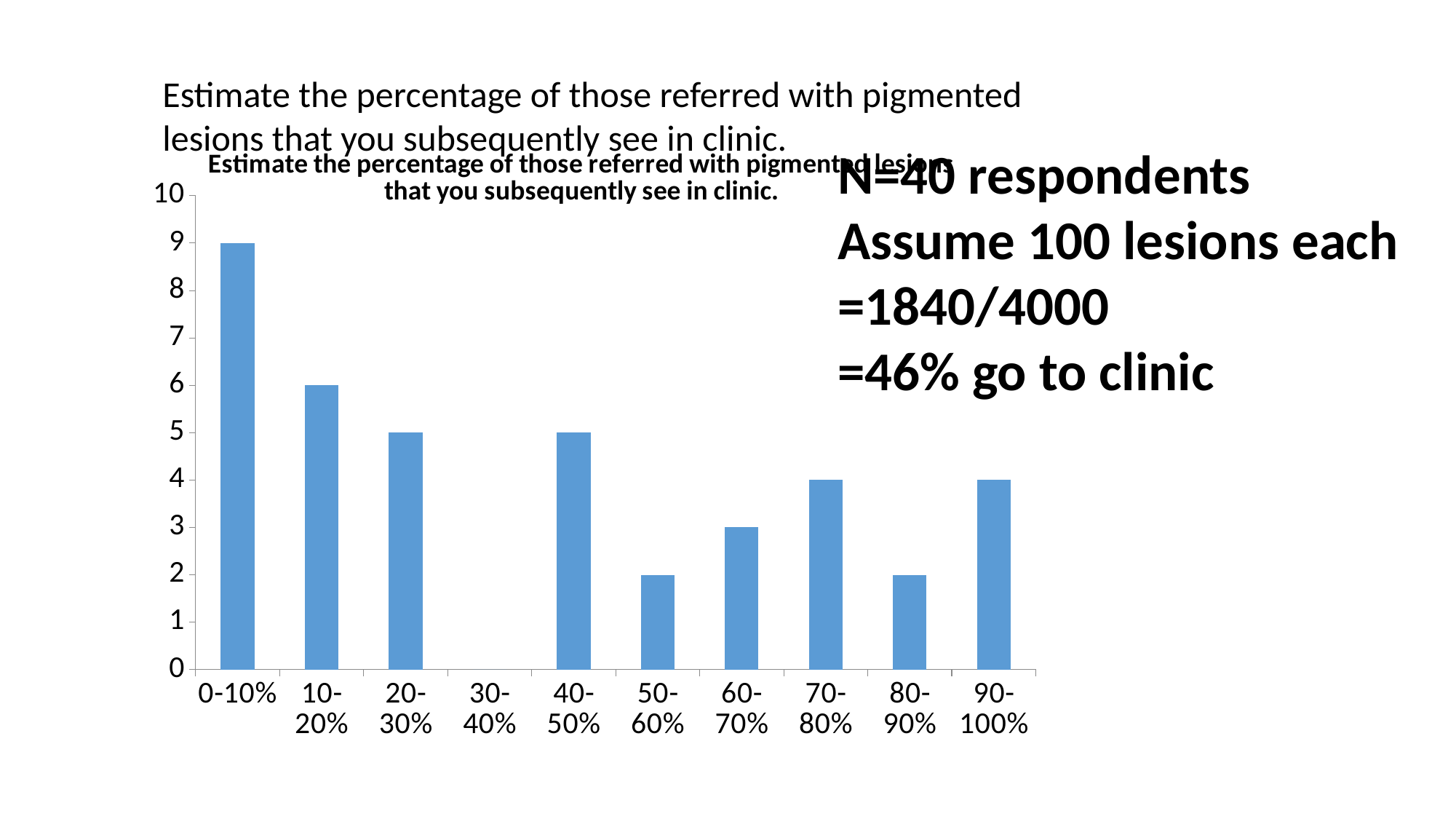
What is the value for the 0-10% category? 9 Which category has the lowest value in the chart? 30-40% What is the value for the 10-20% category? 6 What type of chart is shown on the slide? Bar chart What is the difference between the values for 0-10% and 10-20%? 3 What is the value for the 60-70% category? 3 How many categories are shown on the x axis of the chart? 10 What is the maximum value shown on the y axis of the chart? 10 What is the value for the 90-100% category? 4 Is the value for 0-10% greater or less than 5? greater Which category has the highest value in the chart? 0-10% Which is larger, the value for 20-30% or the value for 50-60%? 20-30%